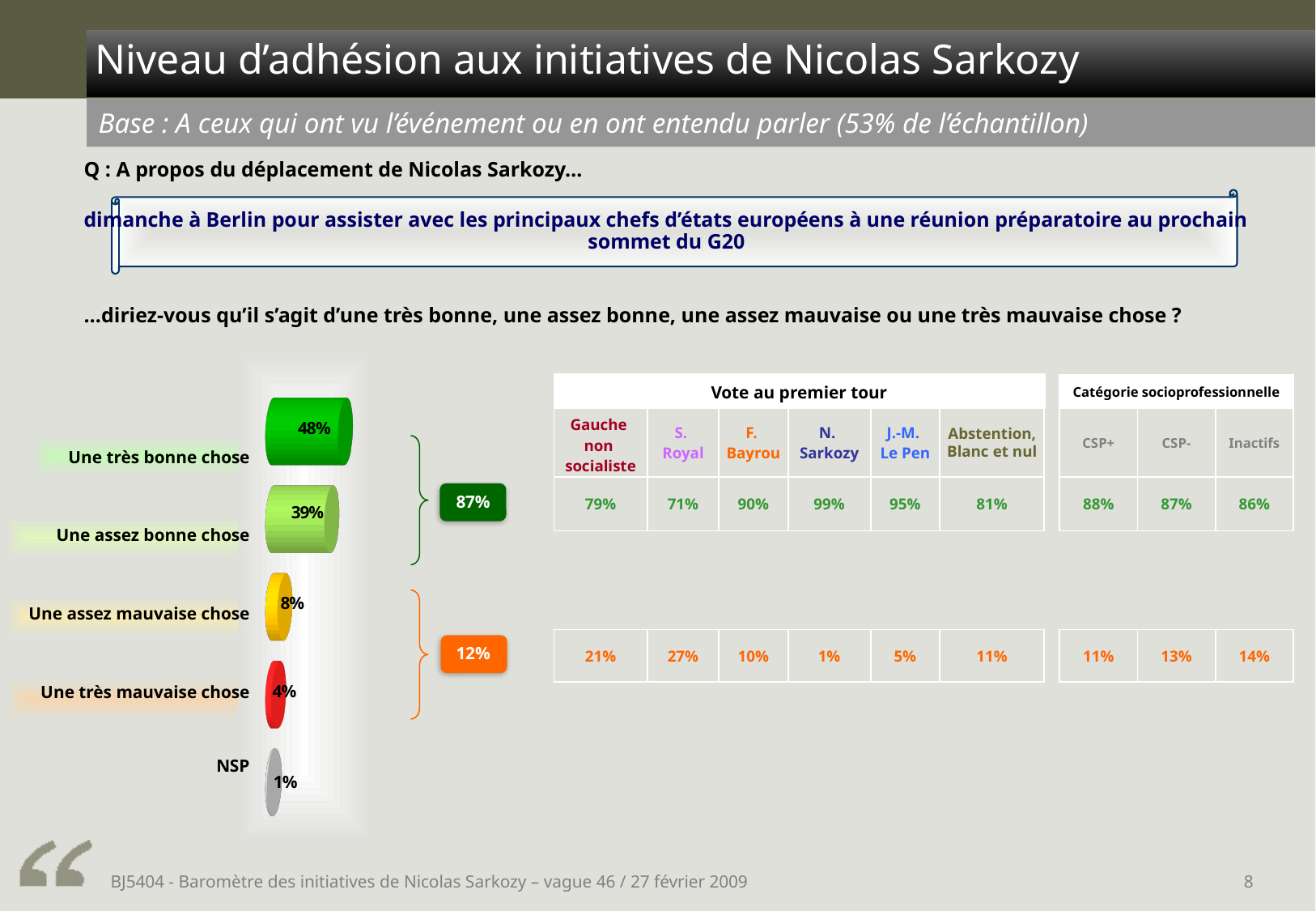
Which is larger, "Une assez mauvaise chose" or "Une très mauvaise chose"? Une assez mauvaise chose What is the value for "NSP"? 1% Which category has the lowest value? NSP Which category has the highest value? Une très bonne chose What is the value for "Une assez bonne chose"? 39% What is the difference between "Une très bonne chose" and "Une assez bonne chose"? 9% What combined value is shown for the two "bonne chose" categories? 87% What is the value for "Une très bonne chose"? 48% What kind of chart is shown on the slide? Bar chart What is the value for "Une très mauvaise chose"? 4% How many categories are shown in the chart? 5 What is the value for "Une assez mauvaise chose"? 8%